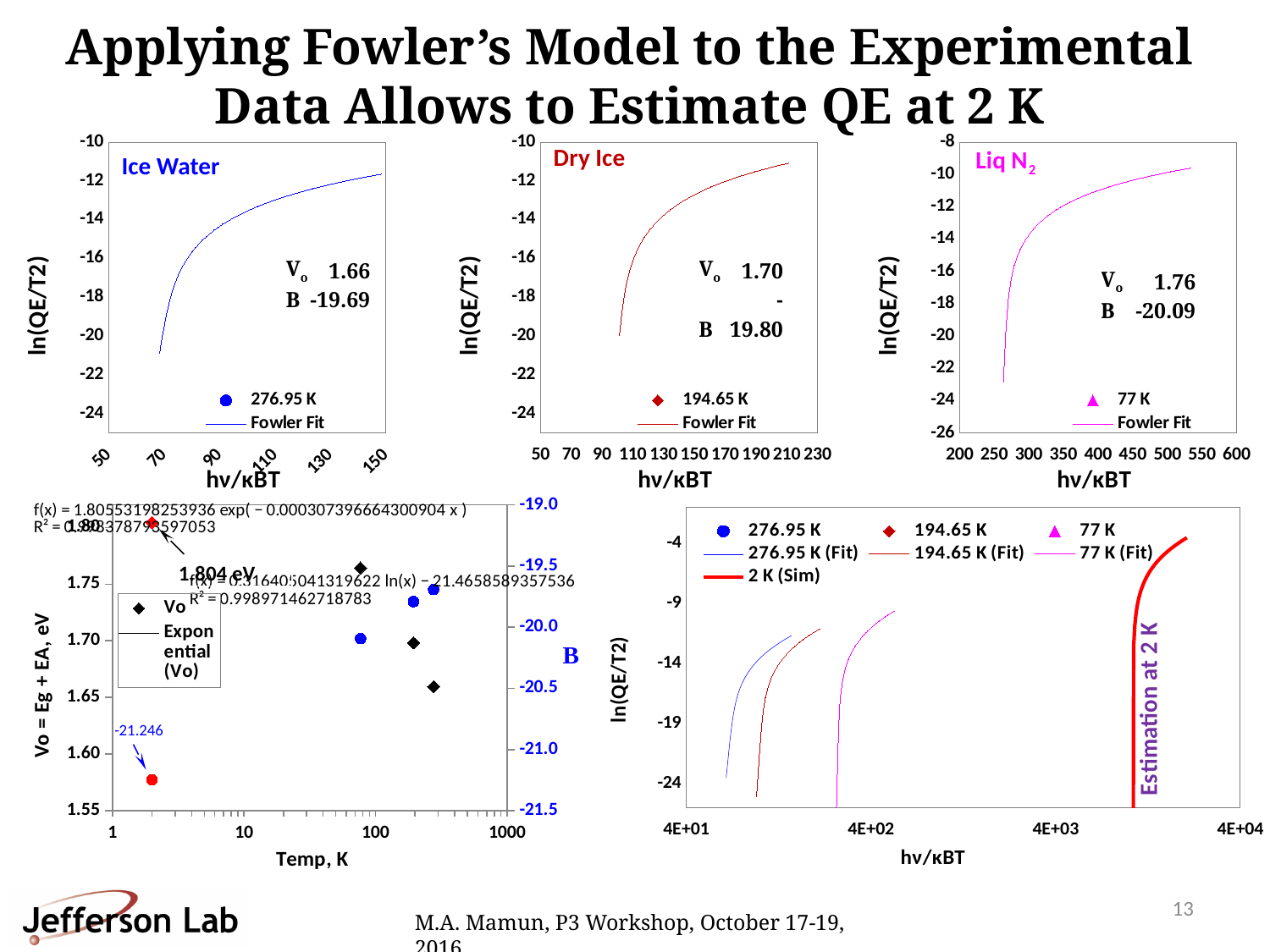
On the Liq N2 chart, what value of Vo is printed? 1.76 What is the difference between the Vo value on the Liq N2 chart and the Vo value on the Ice Water chart? 0.10 Among the Ice Water, Dry Ice and Liq N2 charts, which one shows the highest Vo value? Liq N2 How many entries does the legend of the bottom-right chart list? 7 Is the B value on the Ice Water chart larger or smaller than the B value on the Dry Ice chart? larger On the bottom-left chart (Vo vs Temp), what Vo value is labelled for the point at 2 K? 1.804 eV On the Dry Ice chart, is the highest value reached by the Fowler Fit curve greater or less than -12? greater On the Dry Ice chart, what value of B is printed? -19.80 On the Ice Water chart, what value of Vo is printed? 1.66 On the Ice Water chart, does ln(QE/T2) rise or fall as hv/κBT increases? rise Among the Ice Water, Dry Ice and Liq N2 charts, which one shows the lowest B value? Liq N2 On the bottom-left chart (Vo vs Temp), what B value is labelled for the point at 2 K? -21.246